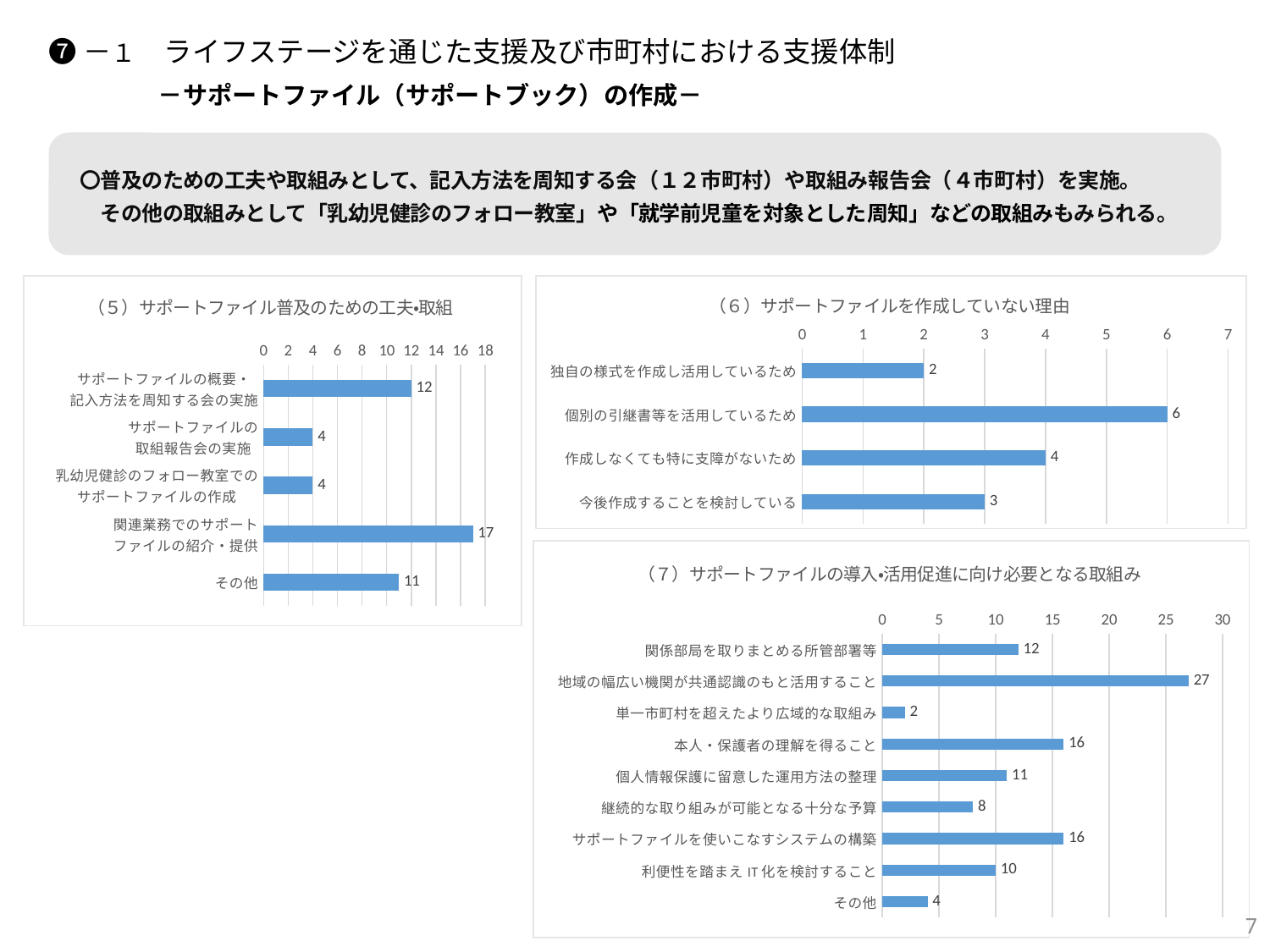
In the chart titled「（5）サポートファイル普及のための工夫•取組」, which category has the highest value? 関連業務でのサポートファイルの紹介・提供 In the chart titled「（5）サポートファイル普及のための工夫•取組」, how many categories are plotted? 5 In the chart titled「（6）サポートファイルを作成していない理由」, which category has the lowest value? 独自の様式を作成し活用しているため What kind of chart is「（6）サポートファイルを作成していない理由」? Bar chart In the chart titled「（7）サポートファイルの導入•活用促進に向け必要となる取組み」, how many categories are plotted? 9 In the chart titled「（7）サポートファイルの導入•活用促進に向け必要となる取組み」, what is the value for 地域の幅広い機関が共通認識のもと活用すること? 27 In the chart titled「（5）サポートファイル普及のための工夫•取組」, what is the value for 関連業務でのサポートファイルの紹介・提供? 17 In the chart titled「（7）サポートファイルの導入•活用促進に向け必要となる取組み」, which is larger: 個人情報保護に留意した運用方法の整理 or 継続的な取り組みが可能となる十分な予算? 個人情報保護に留意した運用方法の整理 In the chart titled「（7）サポートファイルの導入•活用促進に向け必要となる取組み」, which category has the lowest value? 単一市町村を超えたより広域的な取組み In the chart titled「（5）サポートファイル普及のための工夫•取組」, what is the difference between the values for サポートファイルの概要・記入方法を周知する会の実施 and その他? 1 In the chart titled「（6）サポートファイルを作成していない理由」, what is the value for 個別の引継書等を活用しているため? 6 In the chart titled「（6）サポートファイルを作成していない理由」, how many categories are plotted? 4